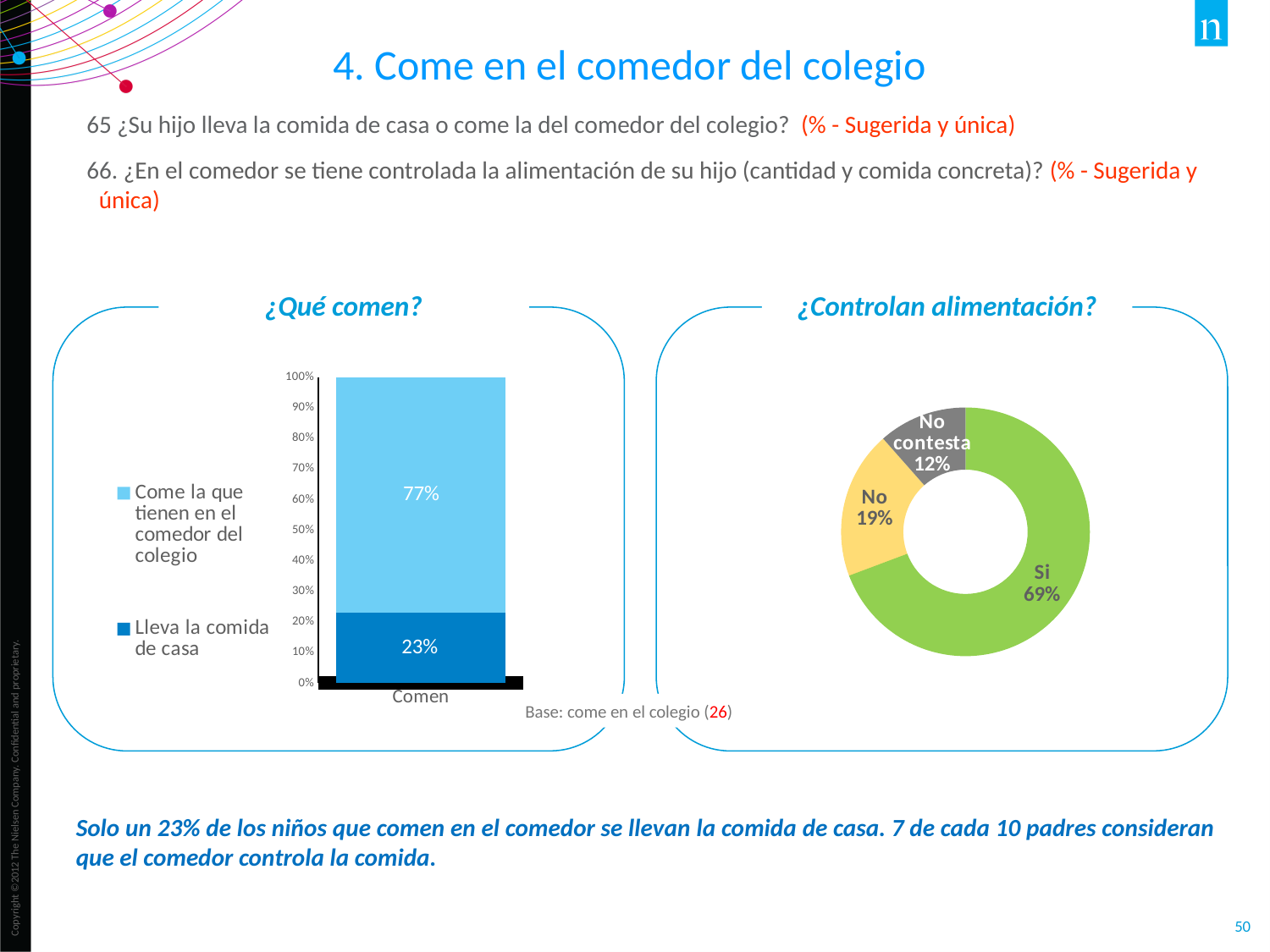
In the '¿Controlan alimentación?' chart, what percentage is 'No contesta'? 12% In the '¿Controlan alimentación?' chart, which category has the smallest share? No contesta In the '¿Controlan alimentación?' chart, what is the difference between the 'Si' share and the 'No' share? 50% In the '¿Qué comen?' chart, what percentage corresponds to 'Come la que tienen en el comedor del colegio'? 77% In the '¿Controlan alimentación?' chart, what percentage answered 'Si'? 69% In the '¿Controlan alimentación?' chart, what percentage answered 'No'? 19% What kind of chart is the '¿Qué comen?' chart? Stacked bar chart In the '¿Qué comen?' chart, what is the total of the stacked bar for 'Comen'? 100% In the '¿Qué comen?' chart, what is the difference between the 'Come la que tienen en el comedor del colegio' share and the 'Lleva la comida de casa' share? 54% In the '¿Qué comen?' chart, how many series does the legend list? 2 In the '¿Qué comen?' chart, what percentage corresponds to 'Lleva la comida de casa'? 23% In the '¿Controlan alimentación?' chart, how many categories are shown? 3